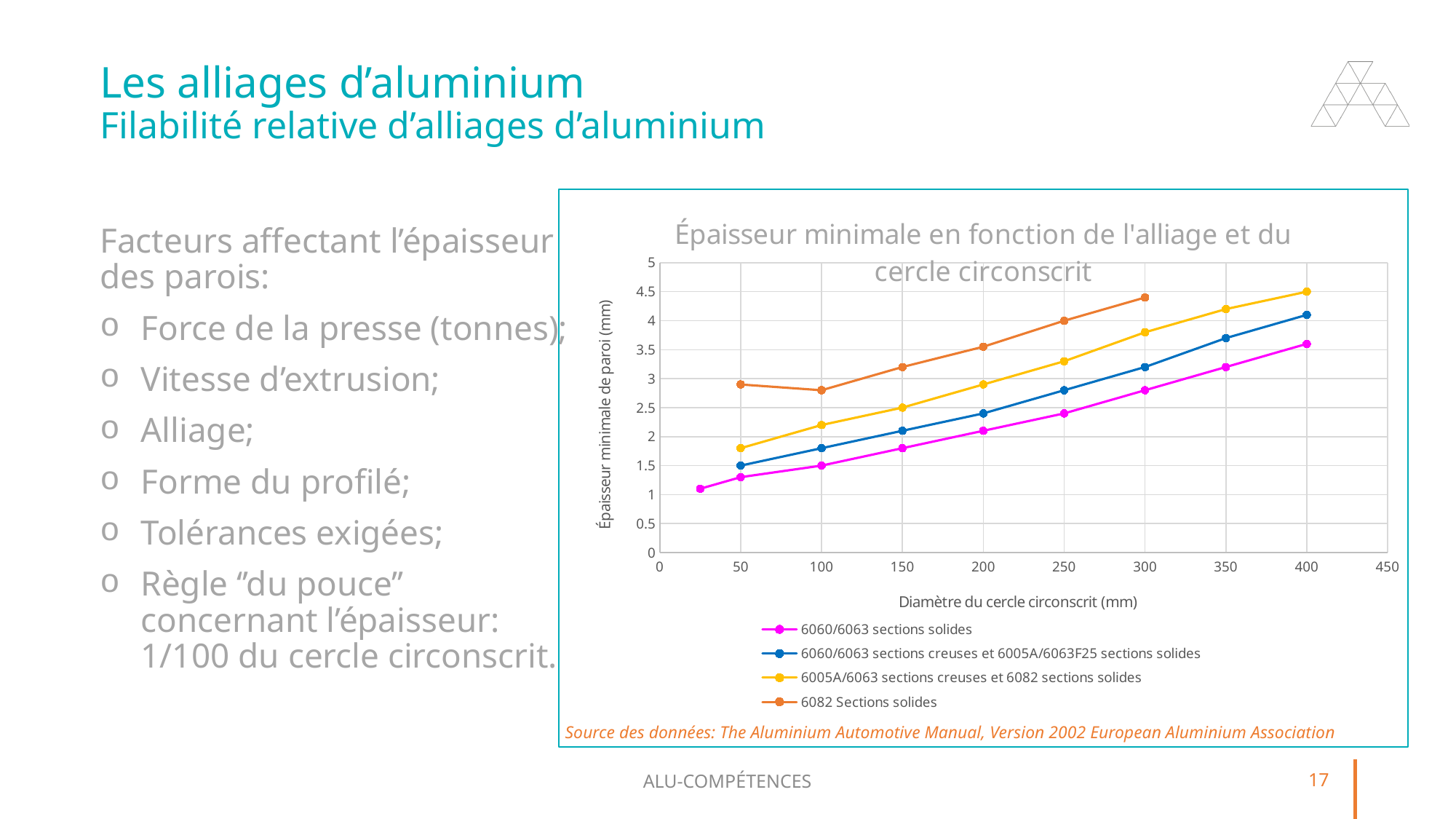
Which series has the highest value at 300 mm? 6082 Sections solides Is the value for '6082 Sections solides' at 50 mm greater or less than 2.5? greater Do the values for the '6060/6063 sections solides' series rise or fall as the diameter increases? rise Is the value for '6082 Sections solides' at 300 mm greater or less than 4? greater What is the title of the chart? Épaisseur minimale en fonction de l'alliage et du cercle circonscrit Is the value for '6060/6063 sections creuses et 6005A/6063F25 sections solides' at 250 mm greater or less than 3? less At 200 mm, which series has the larger value: '6082 Sections solides' or '6060/6063 sections solides'? 6082 Sections solides What kind of chart is shown on the slide? line chart How many series does the chart legend list? 4 What is the x-axis title of the chart? Diamètre du cercle circonscrit (mm)